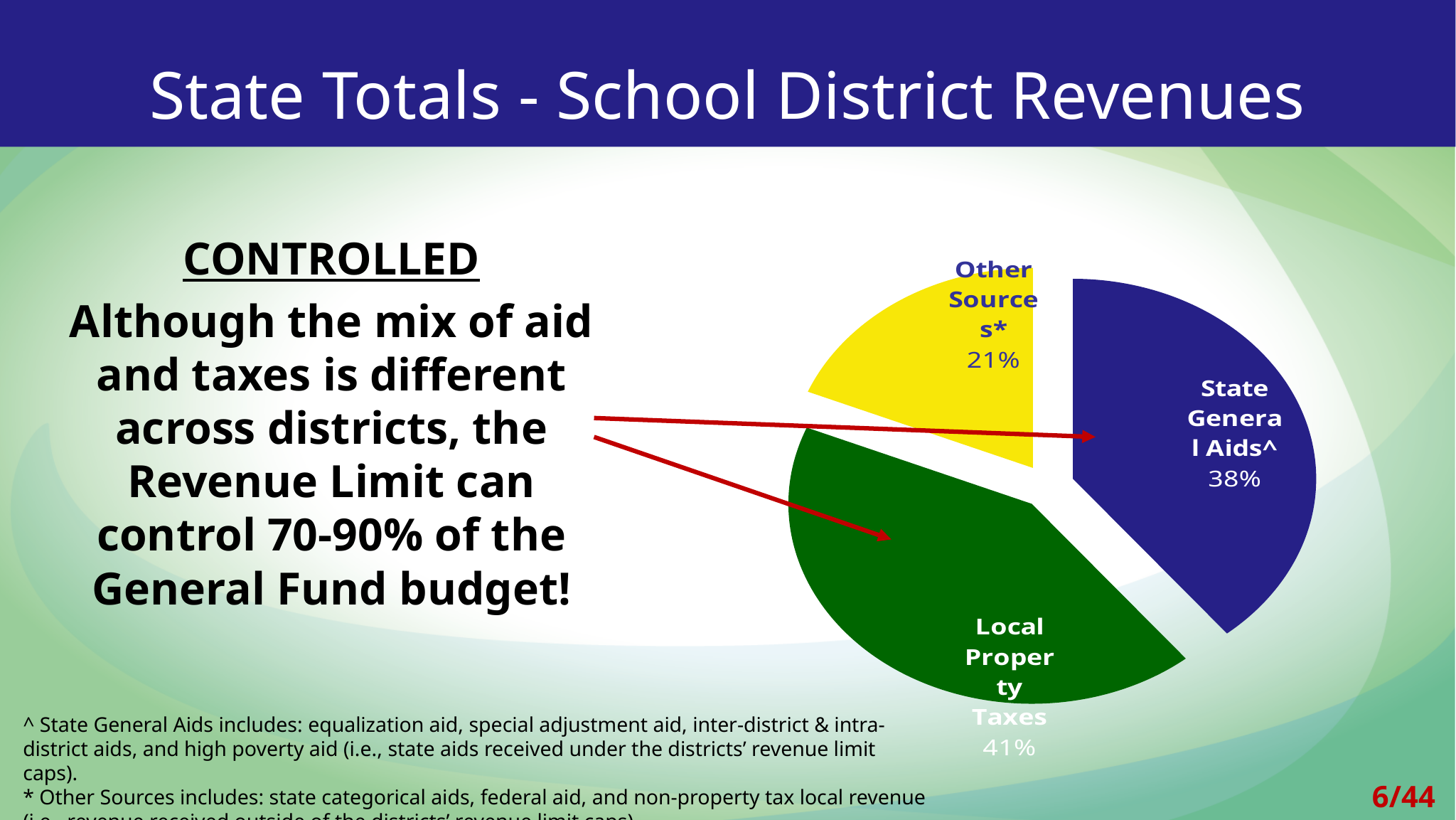
What colour is the State General Aids slice? blue What share of school district revenues comes from State General Aids? 38% Which revenue source has the largest share of the pie? Local Property Taxes What colour is the Other Sources slice? yellow Which revenue source has the smallest share of the pie? Other Sources What is the difference in percentage points between Local Property Taxes and State General Aids? 3 Which is larger, the share for State General Aids or the share for Other Sources? State General Aids What share of school district revenues comes from Local Property Taxes? 41% What kind of chart is shown on the slide? pie chart How many slices does the pie chart have? 3 What share of school district revenues comes from Other Sources? 21% What is the difference in percentage points between Local Property Taxes and Other Sources? 20